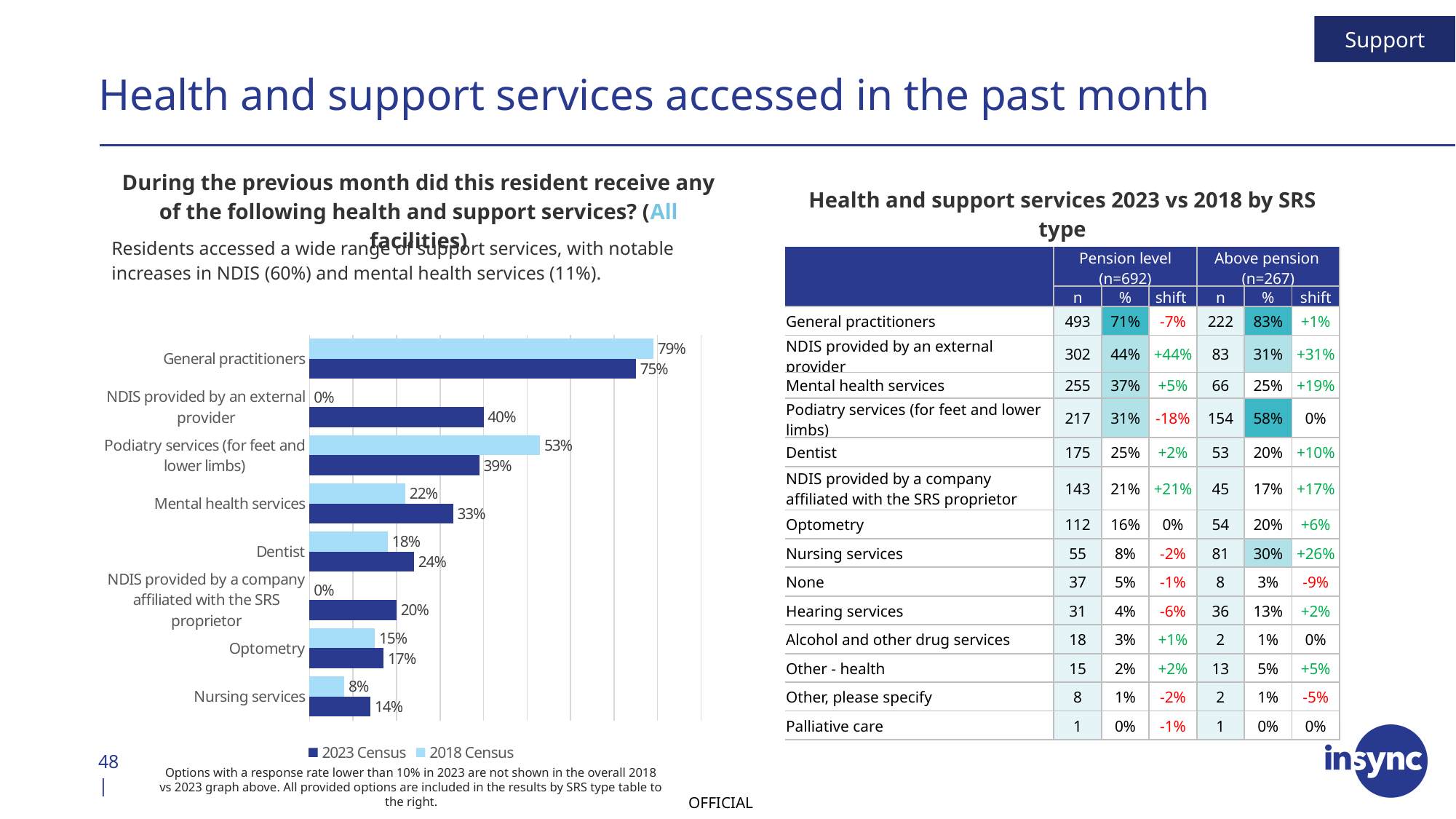
What type of chart is shown on the slide? bar chart What is the difference between the 2018 Census and 2023 Census values for Podiatry services (for feet and lower limbs)? 14% How many categories are shown in the bar chart? 8 What is the 2018 Census value for Podiatry services (for feet and lower limbs)? 53% Which series is shown in dark blue in the chart legend? 2023 Census Which is larger for Dentist: the 2023 Census value or the 2018 Census value? 2023 Census Which category has the lowest 2023 Census value? Nursing services How many series does the chart legend list? 2 What is the 2023 Census value for General practitioners? 75% What is the difference between the 2023 Census and 2018 Census values for Mental health services? 11% Which category has the highest 2023 Census value? General practitioners What is the 2023 Census value for NDIS provided by an external provider? 40%